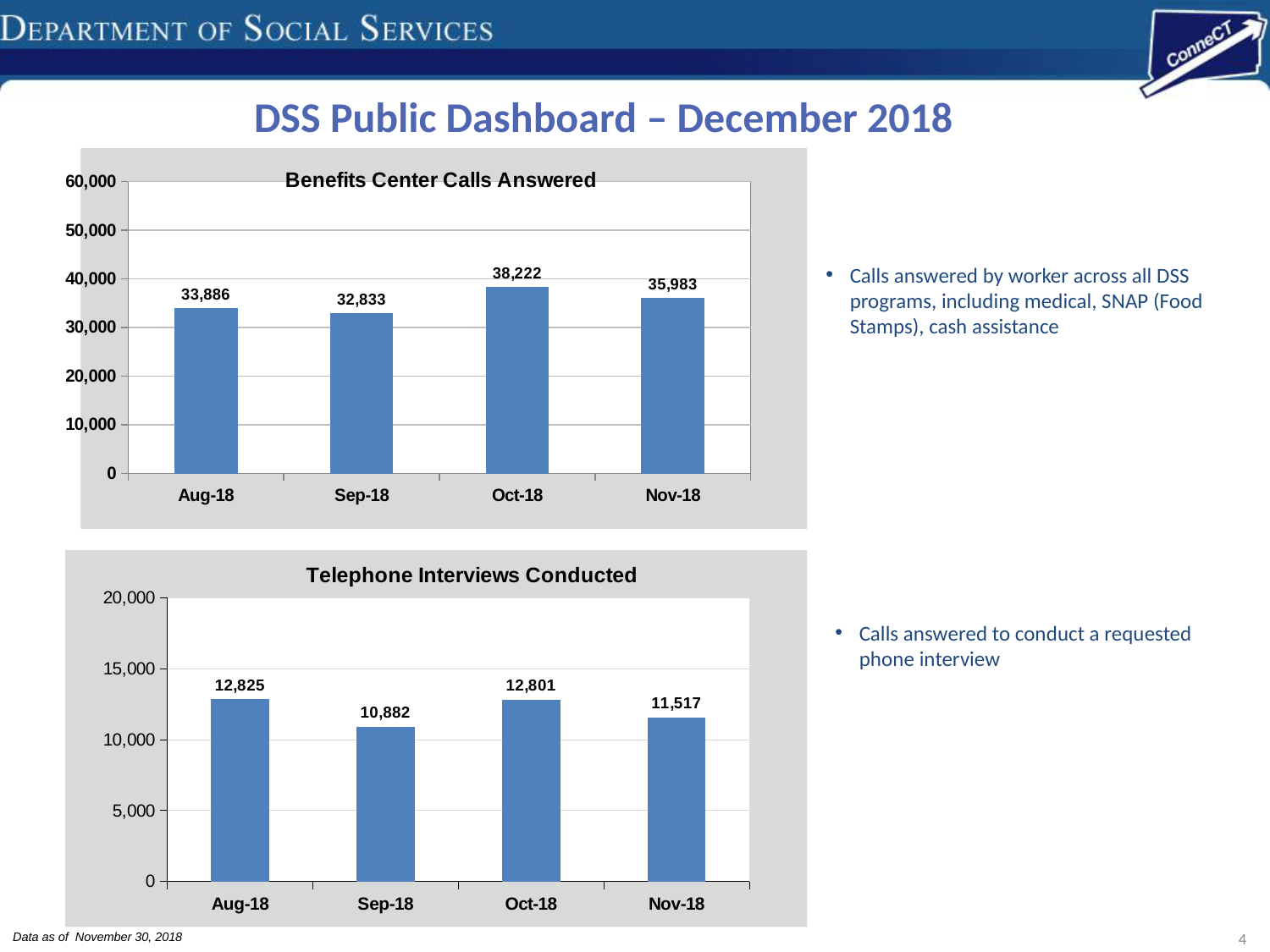
In the Benefits Center Calls Answered chart, which is larger, Aug-18 or Nov-18? Nov-18 In the Benefits Center Calls Answered chart, which month has the highest value? Oct-18 What kind of chart is the Telephone Interviews Conducted chart? bar chart In the Benefits Center Calls Answered chart, what is the value for Oct-18? 38,222 In the Benefits Center Calls Answered chart, which month has the lowest value? Sep-18 In the Benefits Center Calls Answered chart, how many months are shown? 4 In the Telephone Interviews Conducted chart, what is the value for Nov-18? 11,517 In the Benefits Center Calls Answered chart, is the value for Nov-18 greater or less than 30,000? greater In the Telephone Interviews Conducted chart, is the value for Sep-18 greater or less than 15,000? less In the Benefits Center Calls Answered chart, what is the difference between Oct-18 and Sep-18? 5,389 In the Telephone Interviews Conducted chart, which month has the lowest value? Sep-18 In the Telephone Interviews Conducted chart, what is the difference between Aug-18 and Sep-18? 1,943